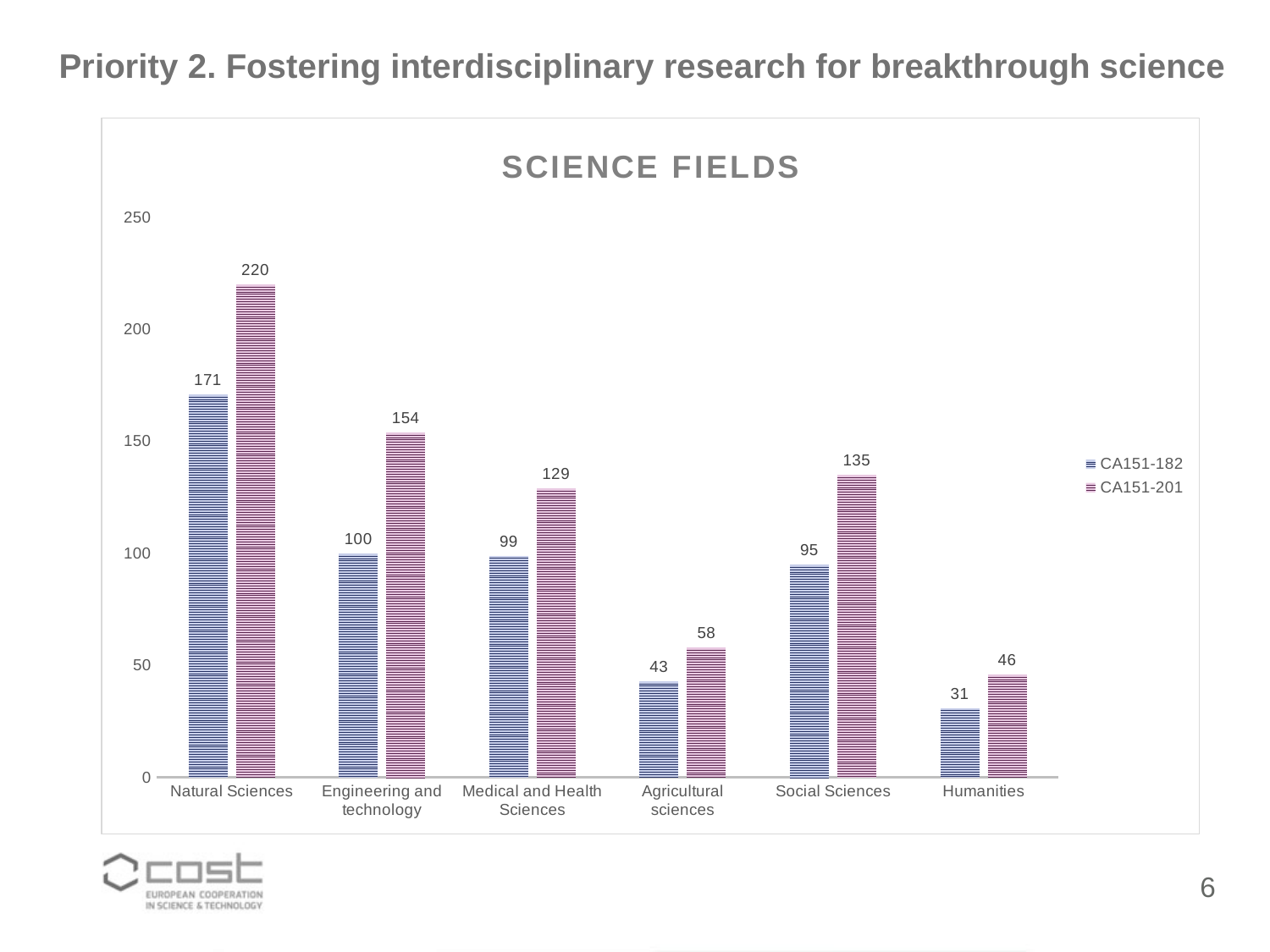
Is the CA151-201 value for Medical and Health Sciences greater or less than 100? greater How many series does the legend list? 2 Which science field has the highest value in the CA151-182 series? Natural Sciences Which science field has the lowest value in the CA151-201 series? Humanities What is the difference between the CA151-201 and CA151-182 values for Engineering and technology? 54 How many science fields are shown on the x axis? 6 What is the title of the chart? SCIENCE FIELDS What kind of chart is shown on the slide? bar chart What is the value for Natural Sciences in the CA151-201 series? 220 What is the value for Humanities in the CA151-182 series? 31 What is the value for Social Sciences in the CA151-201 series? 135 Which is larger for Agricultural sciences: the CA151-182 value or the CA151-201 value? CA151-201